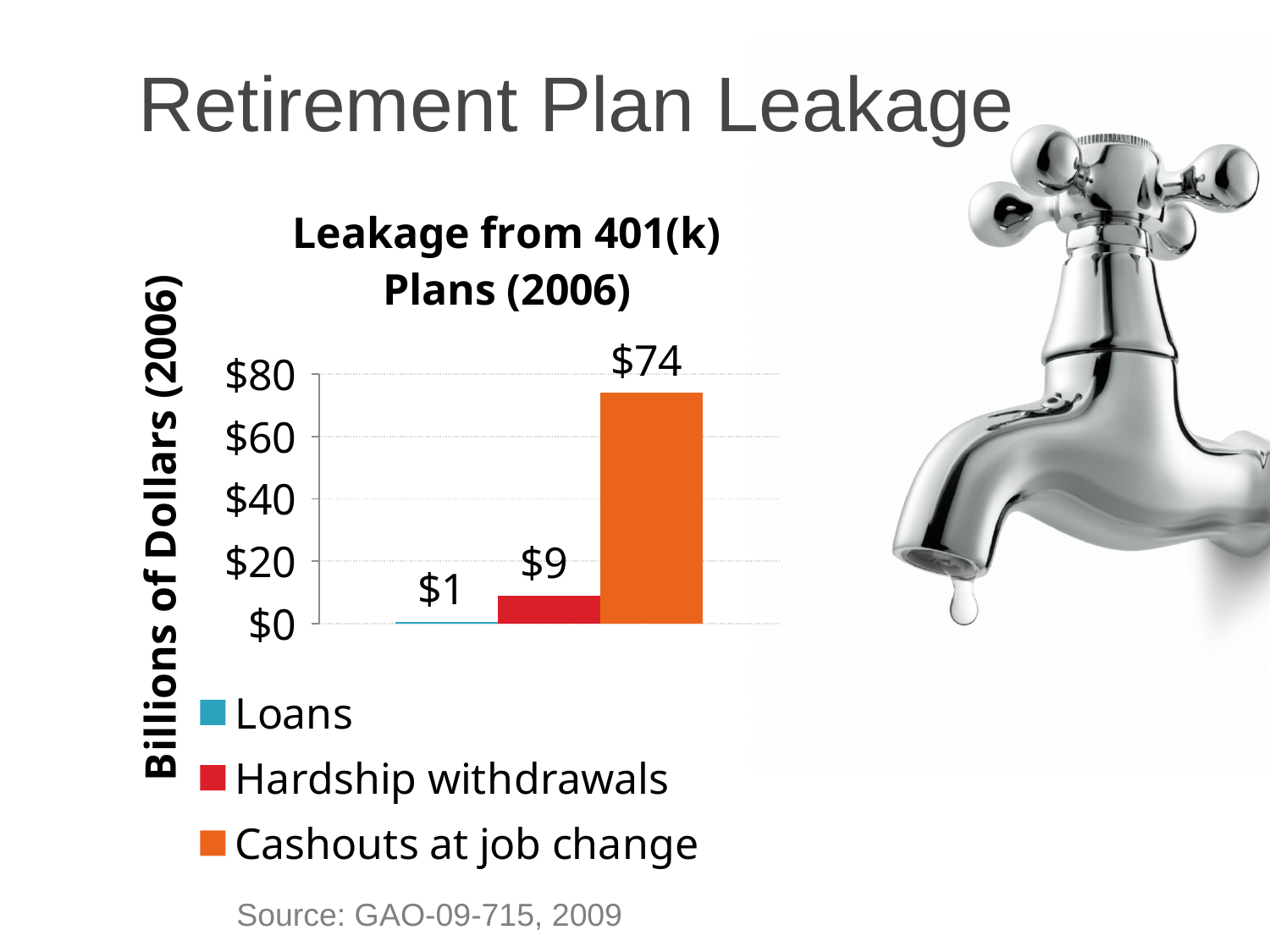
What is the difference between Cashouts at job change and Hardship withdrawals? $65 Which is larger, Hardship withdrawals or Loans? Hardship withdrawals What is the value for Cashouts at job change? $74 Which series has the highest value? Cashouts at job change What is the value for Hardship withdrawals? $9 What is the title of the chart? Leakage from 401(k) Plans (2006) What is the difference between Hardship withdrawals and Loans? $8 Which series has the lowest value? Loans How many series does the legend list? 3 What kind of chart is shown? bar chart What is the value for Loans? $1 Is the value for Cashouts at job change greater or less than $60? greater